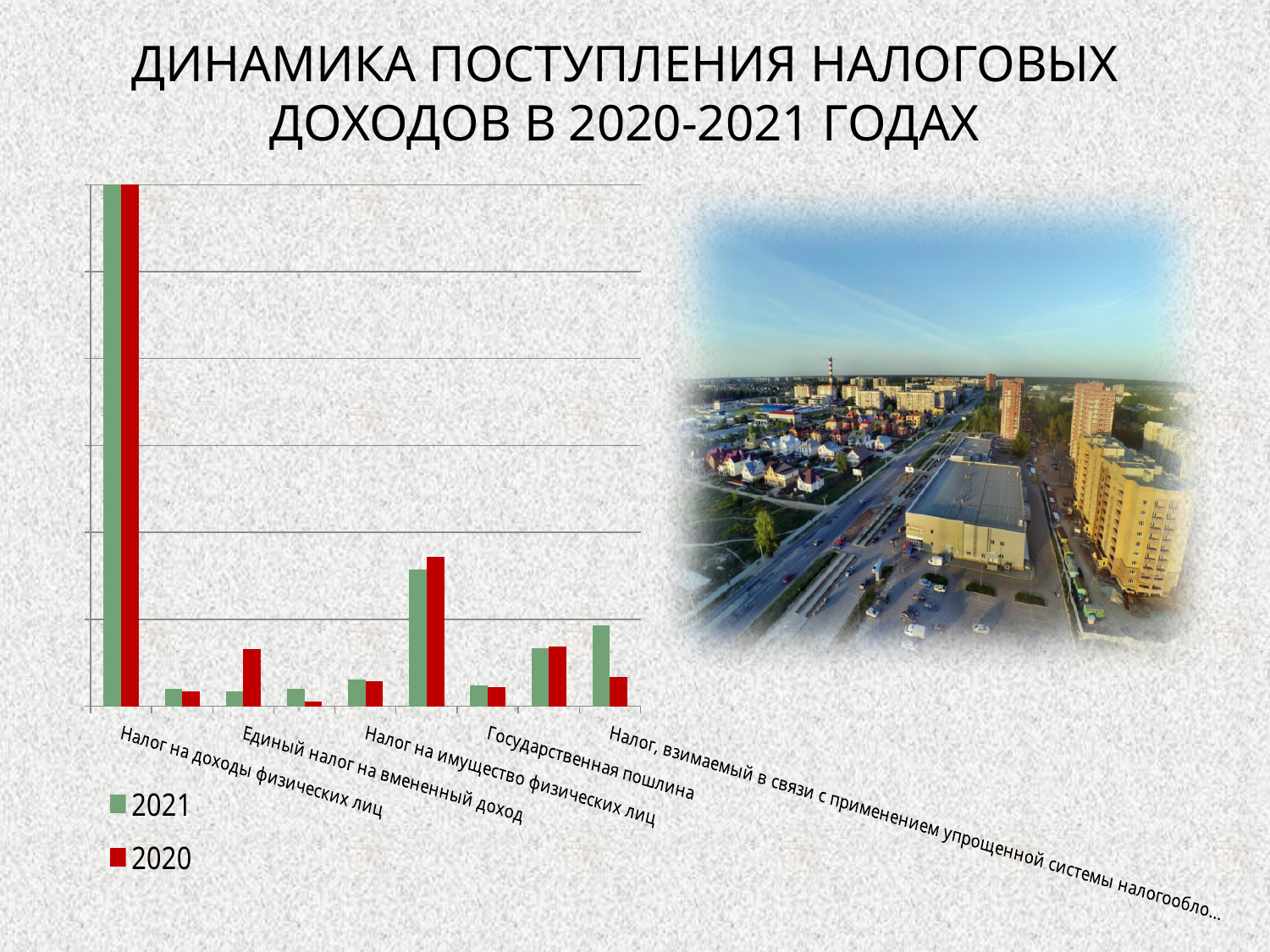
Which series are listed in the chart legend? 2021 and 2020 What kind of chart is shown on the slide? bar chart Is the 2021 bar for Налог на доходы физических лиц larger or smaller than the 2021 bar for Государственная пошлина? larger For Единый налог на вмененный доход, which year has the larger bar, 2021 or 2020? 2020 What colour represents the 2020 series in the chart? red Which category has the highest bars in the chart? Налог на доходы физических лиц For Налог, взимаемый в связи с применением упрощенной системы налогообложения, which year has the larger bar, 2021 or 2020? 2021 How many series does the chart legend list? 2